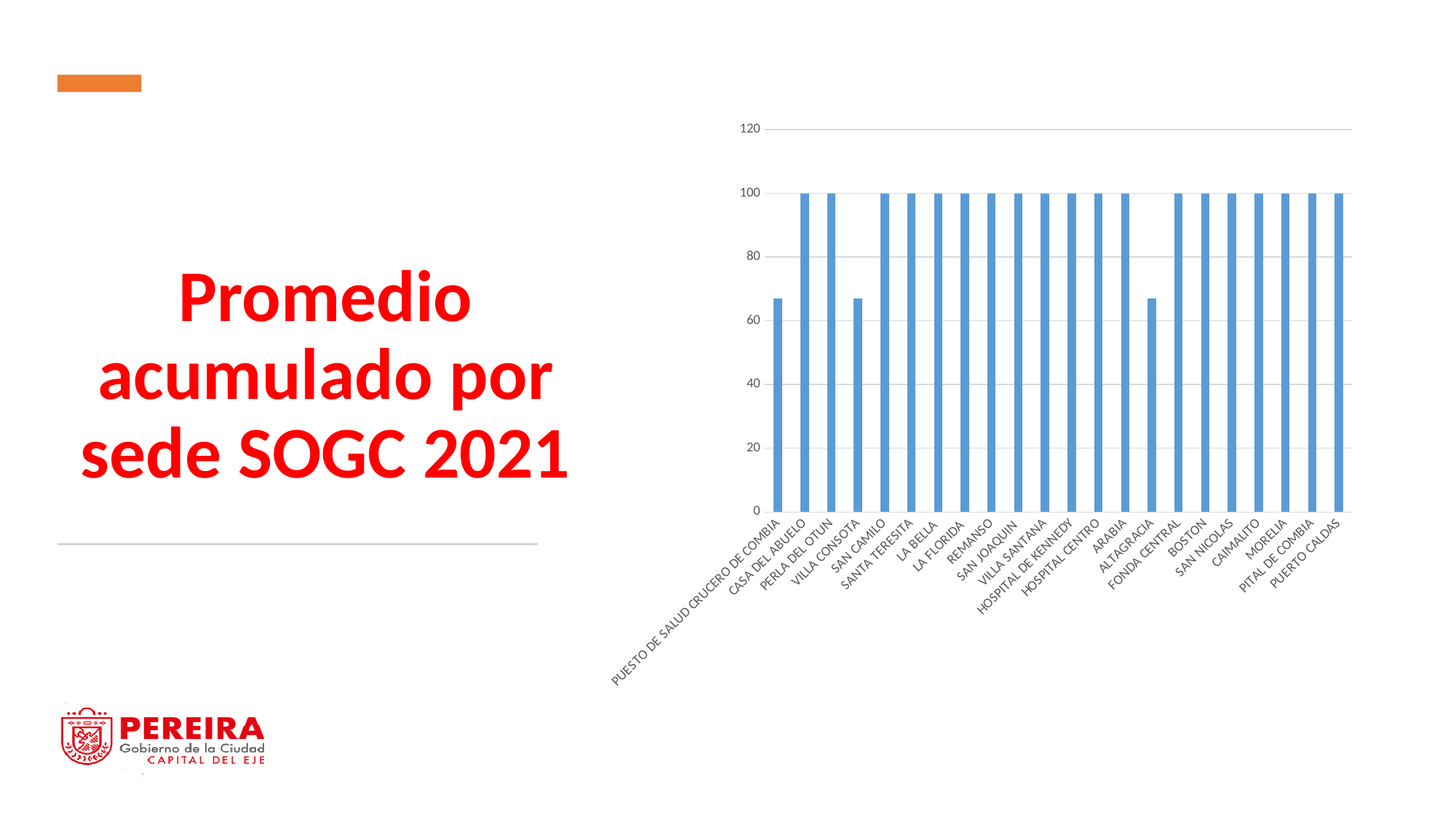
What is the highest value shown on the vertical axis of the chart? 120 What kind of chart is shown on the slide? bar chart Which is larger, the value for ALTAGRACIA or the value for FONDA CENTRAL? FONDA CENTRAL What is the value for HOSPITAL DE KENNEDY? 100 How many sedes (categories) are plotted on the x axis of the chart? 22 Is the value for PUESTO DE SALUD CRUCERO DE COMBIA greater or less than 80? less What is the value for CASA DEL ABUELO? 100 Is the value for ALTAGRACIA greater or less than 60? greater Is the value for VILLA CONSOTA greater or less than 80? less What is the title text on the slide next to the chart? Promedio acumulado por sede SOGC 2021 Which is larger, the value for SAN CAMILO or the value for VILLA CONSOTA? SAN CAMILO What is the value for PUERTO CALDAS? 100